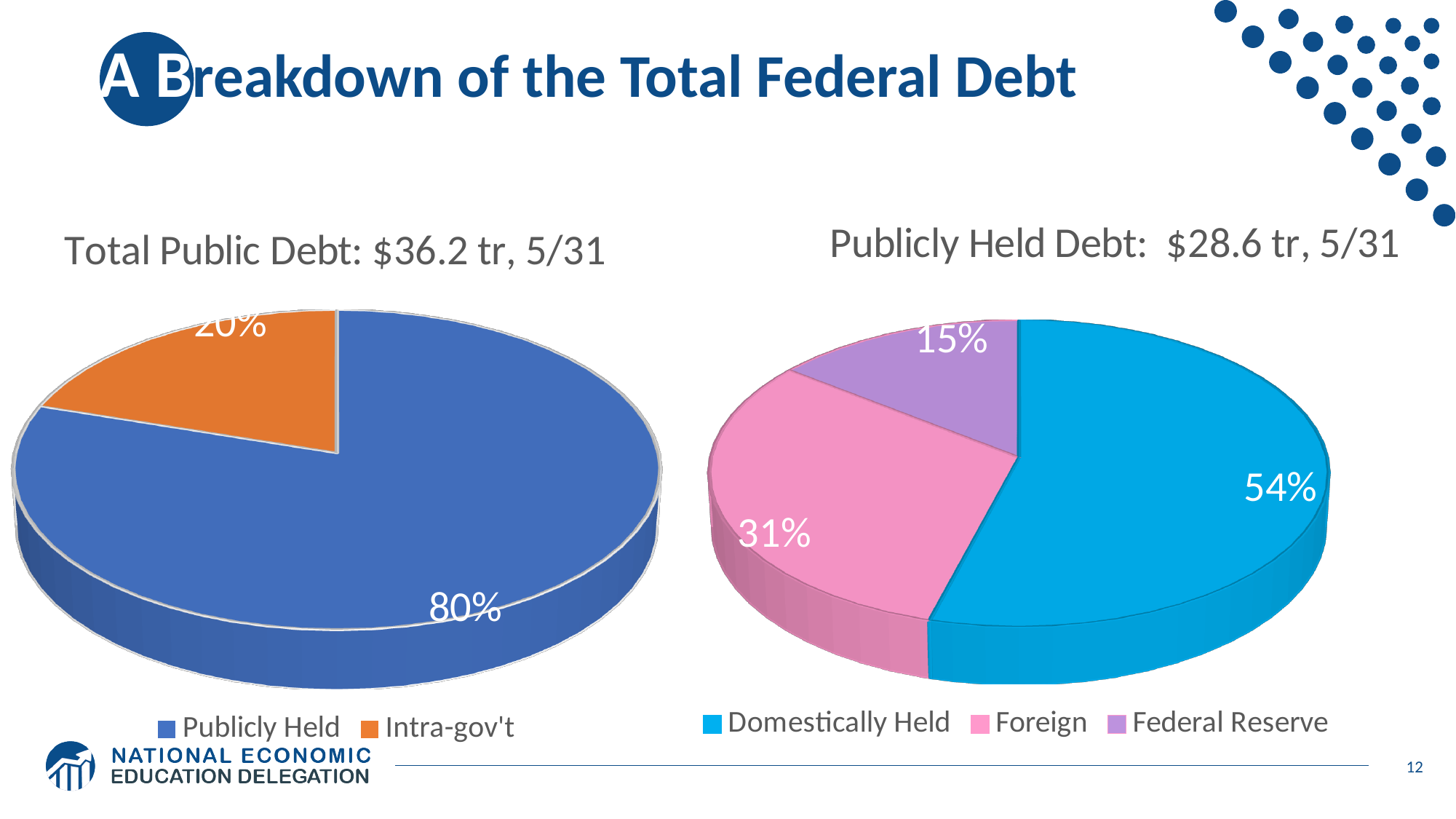
What type of chart is used for 'Total Public Debt'? Pie chart In the 'Publicly Held Debt' pie chart, which category has the smallest share? Federal Reserve In the 'Publicly Held Debt' pie chart, what share is Domestically Held? 54% In the 'Publicly Held Debt' pie chart, what share is Federal Reserve? 15% In the 'Total Public Debt' pie chart, what is the difference in percentage points between Publicly Held and Intra-gov't? 60 In the 'Publicly Held Debt' pie chart, what share is Foreign? 31% In the 'Publicly Held Debt' pie chart, which category has the largest share? Domestically Held In the 'Publicly Held Debt' pie chart, which is larger, Foreign or Federal Reserve? Foreign How many categories does the 'Publicly Held Debt' pie chart show? 3 In the 'Publicly Held Debt' pie chart, what is the difference in percentage points between Foreign and Federal Reserve? 16